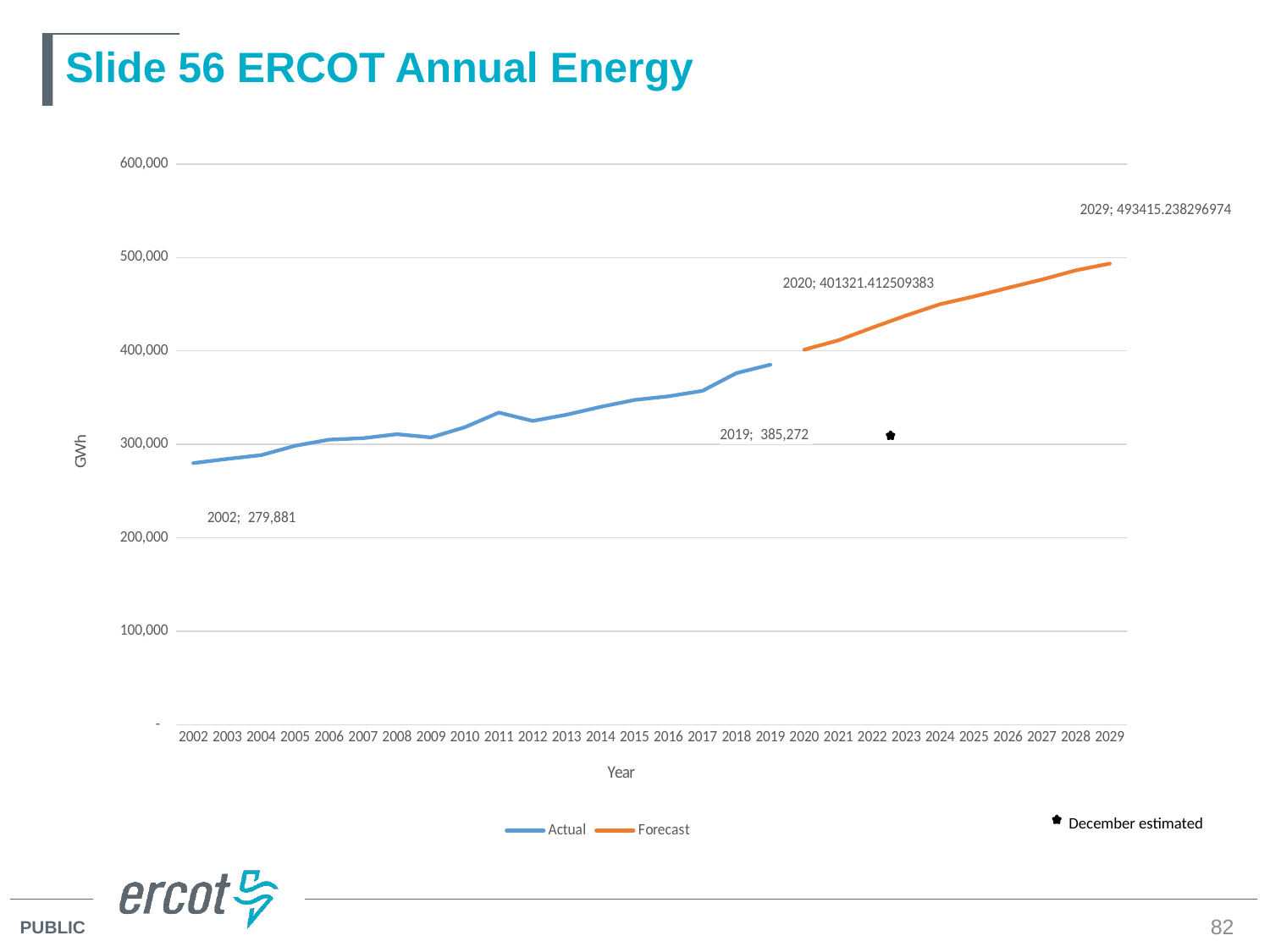
What is the value for 2019 on the Actual series? 385,272 How many years are shown on the x axis? 28 Is the value for 2028 greater or less than 500,000? less What is the difference between the 2019 value and the 2002 value? 105,391 What kind of chart is shown on the slide? line chart Is the value for 2014 greater or less than 300,000? greater What is the value for 2002 on the Actual series? 279,881 What is the value labelled for 2020 on the Forecast series? 401321.412509383 Which year has the highest value on the chart? 2029 What is the value labelled for 2029 on the Forecast series? 493415.238296974 Which year has the lowest value on the chart? 2002 How many series does the legend list? 2